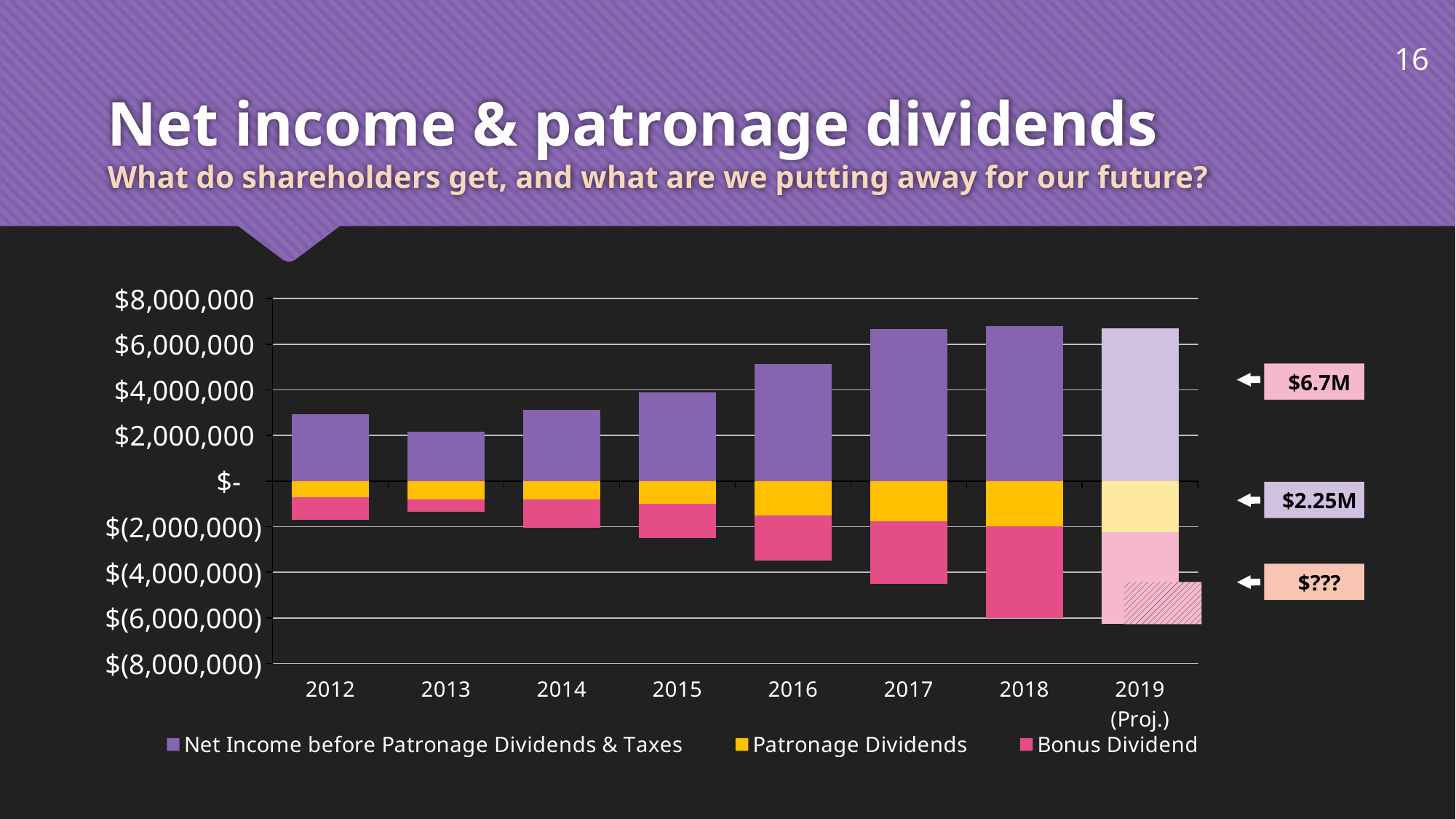
Which year has the larger Net Income before Patronage Dividends & Taxes, 2015 or 2016? 2016 What is the annotated value of the Bonus Dividend for 2019 (Proj.)? $??? How many years are shown along the x axis of the chart? 8 Is the Net Income before Patronage Dividends & Taxes for 2012 greater or less than $2,000,000? greater What is the annotated value of Patronage Dividends for 2019 (Proj.)? $2.25M From 2013 to 2018, does Net Income before Patronage Dividends & Taxes rise or fall? rise Which year has the lowest Net Income before Patronage Dividends & Taxes? 2013 What is the annotated value of Net Income before Patronage Dividends & Taxes for 2019 (Proj.)? $6.7M Is the Net Income before Patronage Dividends & Taxes for 2013 greater or less than $4,000,000? less How many series does the chart legend list? 3 Is the Net Income before Patronage Dividends & Taxes for 2017 greater or less than $6,000,000? greater What kind of chart is shown on the slide? Stacked bar chart